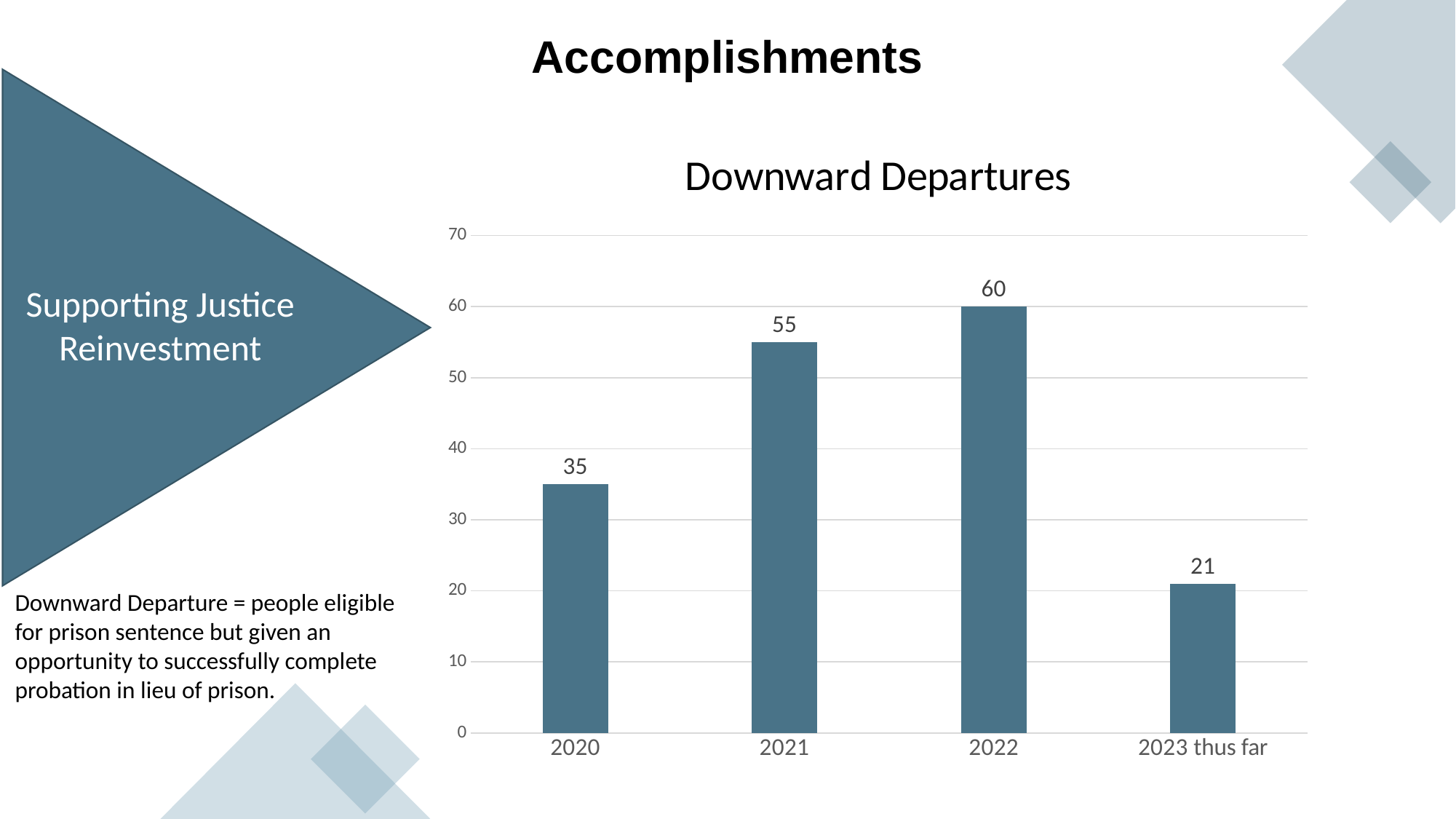
What is the value for 2021 in the Downward Departures chart? 55 How many categories are shown on the x axis of the Downward Departures chart? 4 Which category has the lowest value in the Downward Departures chart? 2023 thus far Which is larger in the Downward Departures chart, the value for 2021 or the value for 2020? 2021 What is the value for 2022 in the Downward Departures chart? 60 Which category has the highest value in the Downward Departures chart? 2022 What kind of chart is the Downward Departures chart? bar chart Is the value for 2023 thus far greater or less than 30 in the Downward Departures chart? less What is the value for 2020 in the Downward Departures chart? 35 What is the difference between the values for 2022 and 2020 in the Downward Departures chart? 25 What is the value for 2023 thus far in the Downward Departures chart? 21 What is the title of the chart on the slide? Downward Departures